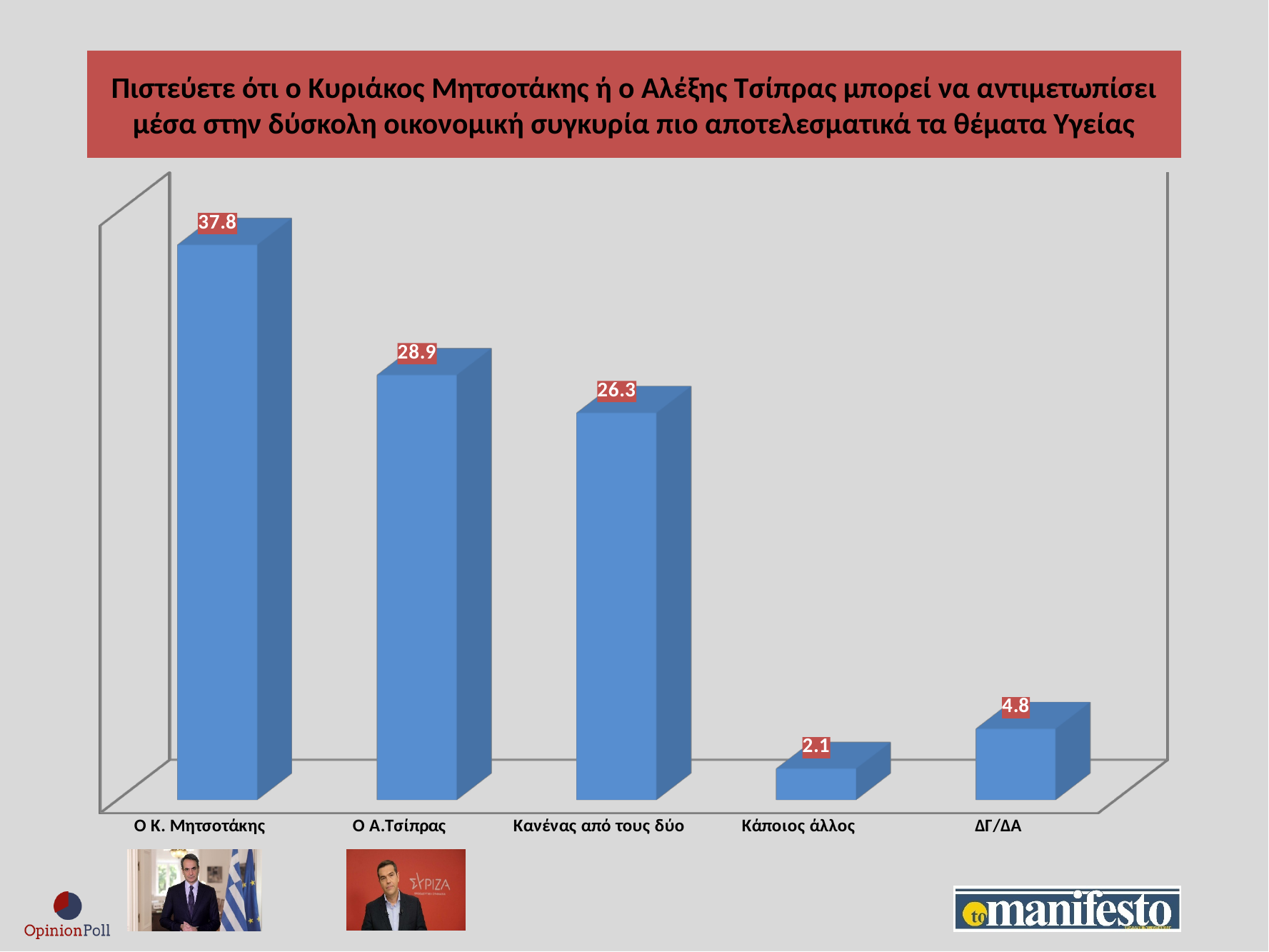
What kind of chart is shown on the slide? Bar chart What is the difference between the values for Ο Κ. Μητσοτάκης and Ο Α.Τσίπρας? 8.9 What is the value for ΔΓ/ΔΑ? 4.8 What is the value for Ο Α.Τσίπρας? 28.9 How many categories are shown on the chart? 5 What is the difference between the values for ΔΓ/ΔΑ and Κάποιος άλλος? 2.7 Which is larger, the value for Ο Α.Τσίπρας or the value for Κανένας από τους δύο? Ο Α.Τσίπρας What is the value for Κάποιος άλλος? 2.1 What is the value for Ο Κ. Μητσοτάκης? 37.8 Which category has the lowest value? Κάποιος άλλος What is the value for Κανένας από τους δύο? 26.3 Which category has the highest value? Ο Κ. Μητσοτάκης